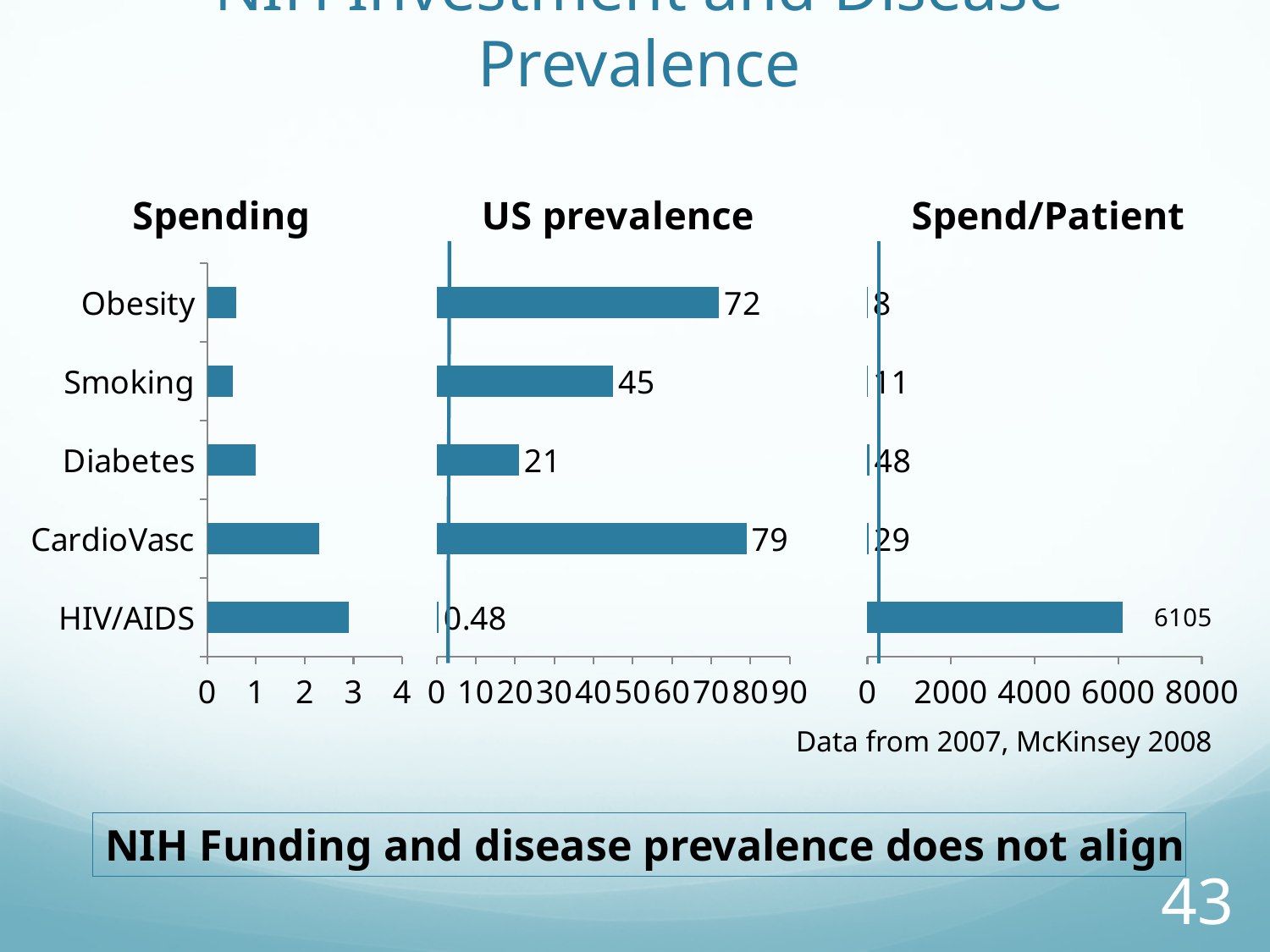
In the Spend/Patient chart, what is the value for Diabetes? 48 In the US prevalence chart, which category has the highest value? CardioVasc In the US prevalence chart, what is the value for CardioVasc? 79 How many categories are shown in the US prevalence chart? 5 In the Spending chart, is the value for HIV/AIDS greater or less than 2? greater In the US prevalence chart, what is the difference between the values for Obesity and Smoking? 27 In the Spending chart, is the value for Obesity greater or less than 1? less In the Spend/Patient chart, which category has the lowest value? Obesity In the US prevalence chart, what is the value for HIV/AIDS? 0.48 In the Spending chart, which category has the highest value? HIV/AIDS In the Spend/Patient chart, which is larger, the value for Smoking or the value for CardioVasc? CardioVasc In the Spend/Patient chart, what is the value for HIV/AIDS? 6105